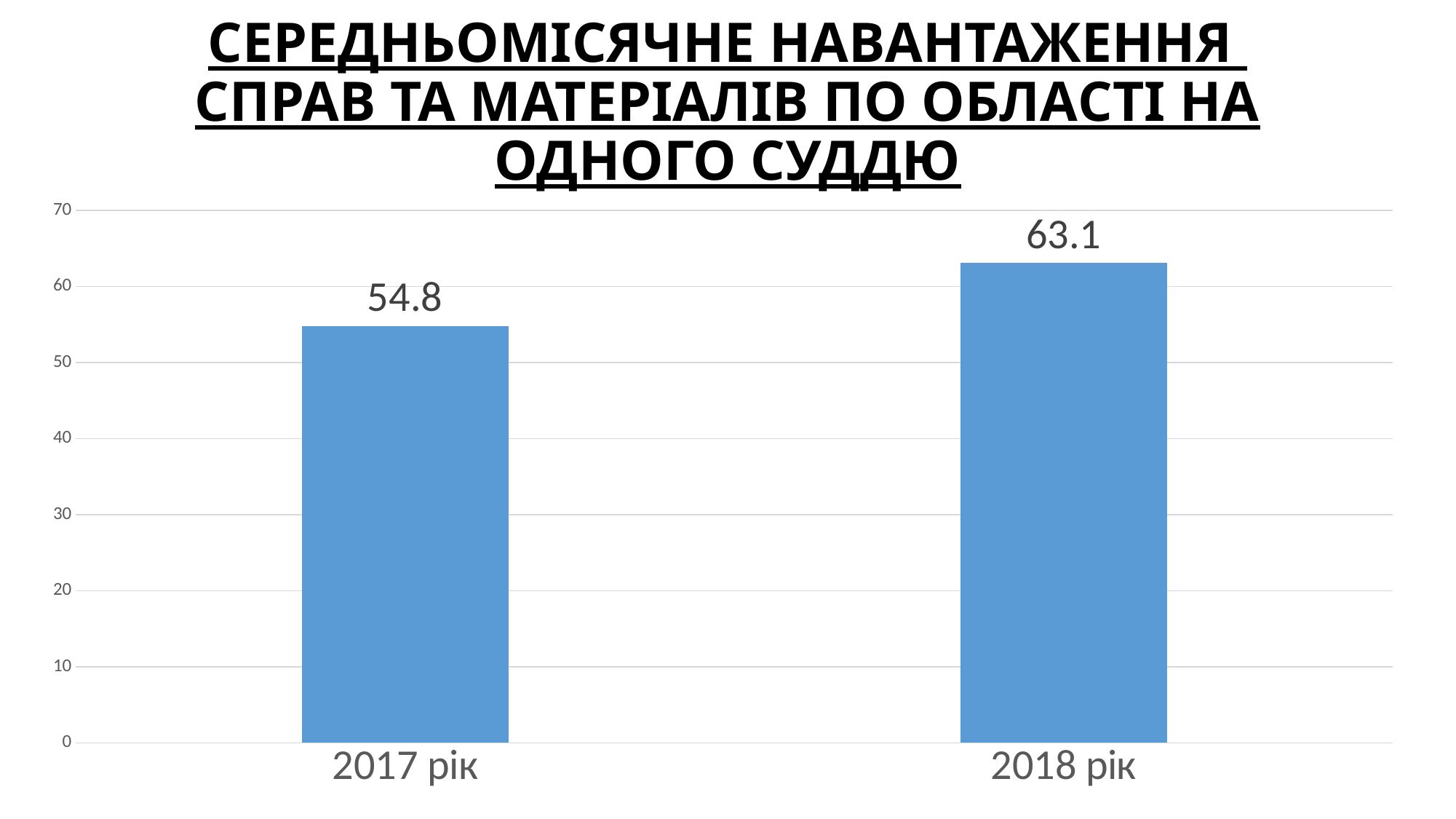
How many categories are shown on the chart? 2 What colour are the bars on the chart? blue Which year has the highest value? 2018 рік What is the value for 2018 рік? 63.1 Is the value for 2017 рік greater or less than 60? less What is the difference between the values for 2018 рік and 2017 рік? 8.3 Is the value for 2018 рік greater or less than 60? greater Which is larger, the value for 2017 рік or the value for 2018 рік? 2018 рік What is the value for 2017 рік? 54.8 Which year has the lowest value? 2017 рік What kind of chart is shown on the slide? bar chart Do the values rise or fall from 2017 рік to 2018 рік? rise